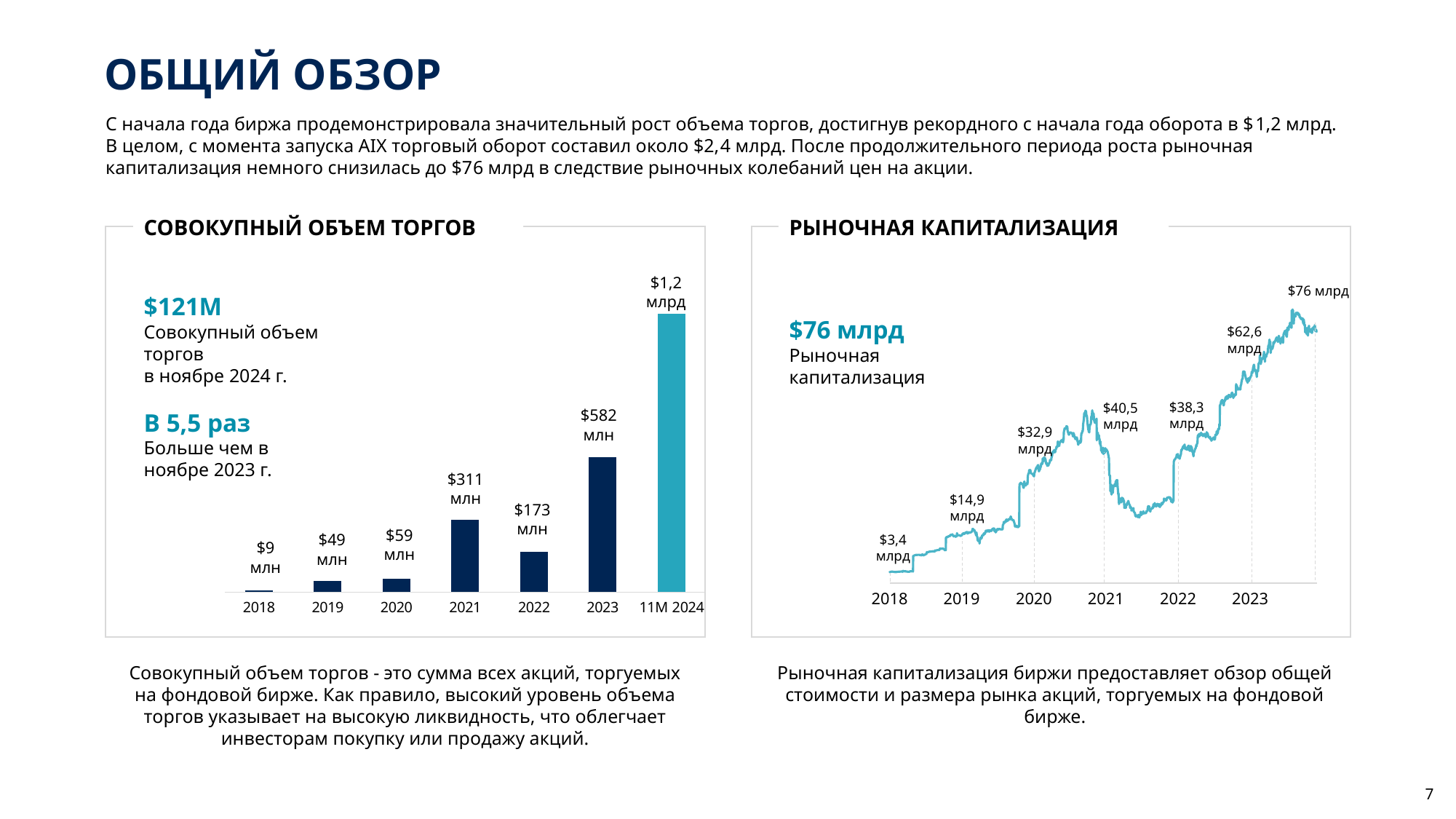
In the 'СОВОКУПНЫЙ ОБЪЕМ ТОРГОВ' chart, what is the value for 2023? $582 млн What kind of chart is the 'РЫНОЧНАЯ КАПИТАЛИЗАЦИЯ' chart? line chart In the 'РЫНОЧНАЯ КАПИТАЛИЗАЦИЯ' chart, does the line overall rise or fall from 2018 to the end of the series? rise In the 'СОВОКУПНЫЙ ОБЪЕМ ТОРГОВ' chart, which category has the highest value? 11M 2024 In the 'СОВОКУПНЫЙ ОБЪЕМ ТОРГОВ' chart, what is the value for 11M 2024? $1,2 млрд In the 'РЫНОЧНАЯ КАПИТАЛИЗАЦИЯ' chart, what value is labelled at 2019? $14,9 млрд In the 'СОВОКУПНЫЙ ОБЪЕМ ТОРГОВ' chart, which is larger, the value for 2021 or for 2022? 2021 What kind of chart is the 'СОВОКУПНЫЙ ОБЪЕМ ТОРГОВ' chart? bar chart In the 'СОВОКУПНЫЙ ОБЪЕМ ТОРГОВ' chart, which year has the lowest value? 2018 How many categories are shown on the x axis of the 'СОВОКУПНЫЙ ОБЪЕМ ТОРГОВ' chart? 7 In the 'РЫНОЧНАЯ КАПИТАЛИЗАЦИЯ' chart, what is the difference between the labelled values $62,6 млрд and $38,3 млрд? $24,3 млрд In the 'СОВОКУПНЫЙ ОБЪЕМ ТОРГОВ' chart, what is the difference between the 2023 and 2022 values? $409 млн